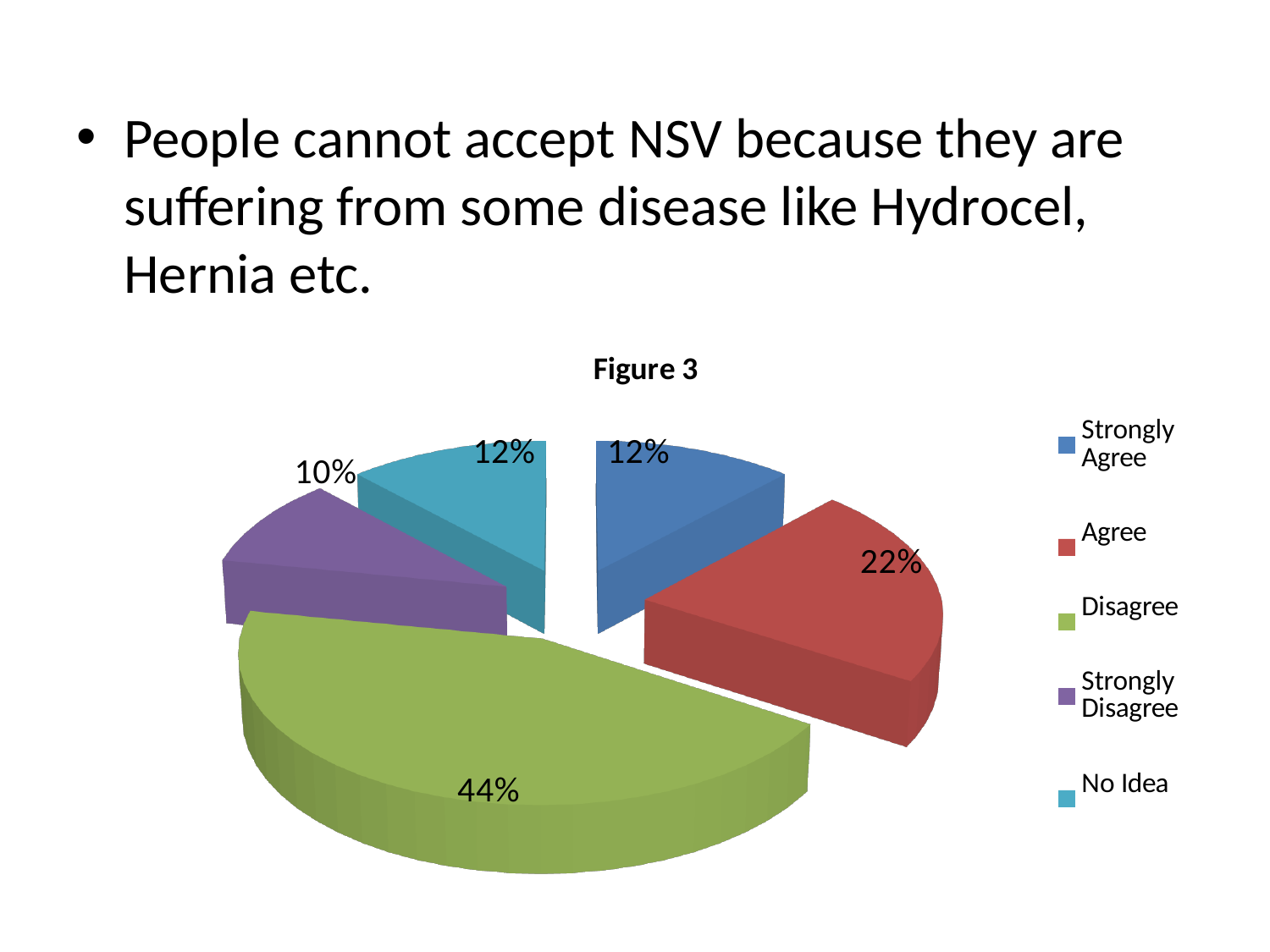
Which category has the largest share of the pie? Disagree What percentage of the pie is Agree? 22% What percentage of the pie is Strongly Disagree? 10% What percentage of the pie is Disagree? 44% What percentage of the pie is No Idea? 12% Which is larger, the share for Agree or the share for Strongly Agree? Agree What is the difference in percentage points between Disagree and Agree? 22 What type of chart is shown in Figure 3? pie chart Which category has the smallest share of the pie? Strongly Disagree What percentage of the pie is Strongly Agree? 12% What is the title of the chart? Figure 3 How many categories does the legend list? 5